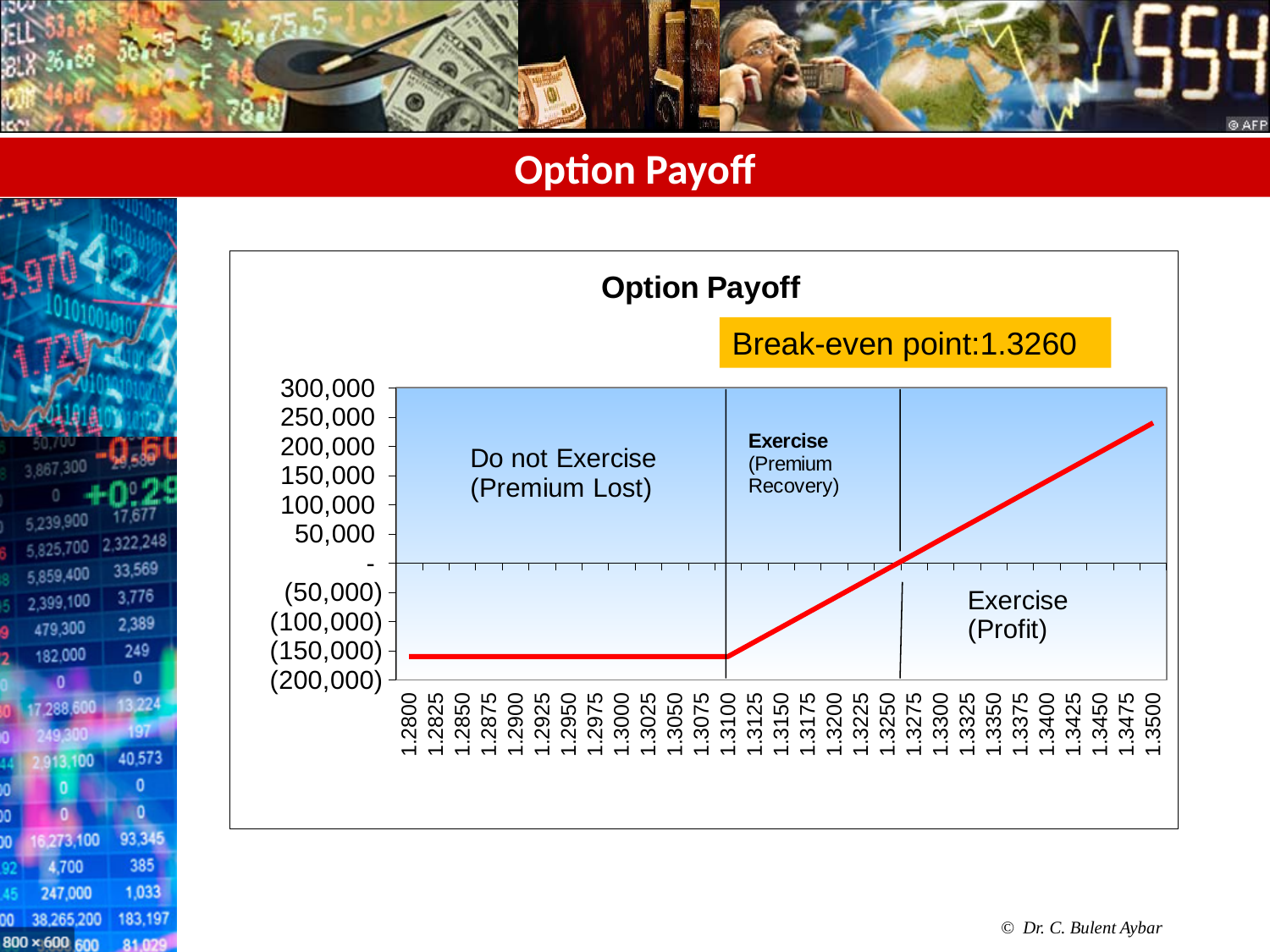
What break-even point is annotated on the chart? 1.3260 Between 1.3100 and 1.3500, does the payoff line rise or fall? rise Is the payoff value at 1.3300 greater or less than 0? greater Which has the larger payoff value, 1.2800 or 1.3500? 1.3500 At which x-axis value does the payoff line reach its highest point? 1.3500 How many exchange-rate values are labelled along the x axis? 29 Is the payoff value at 1.2800 greater or less than (100,000)? less Is the payoff value at 1.3200 greater or less than 0? less What kind of chart is shown on the slide? line chart What is the title of the chart? Option Payoff